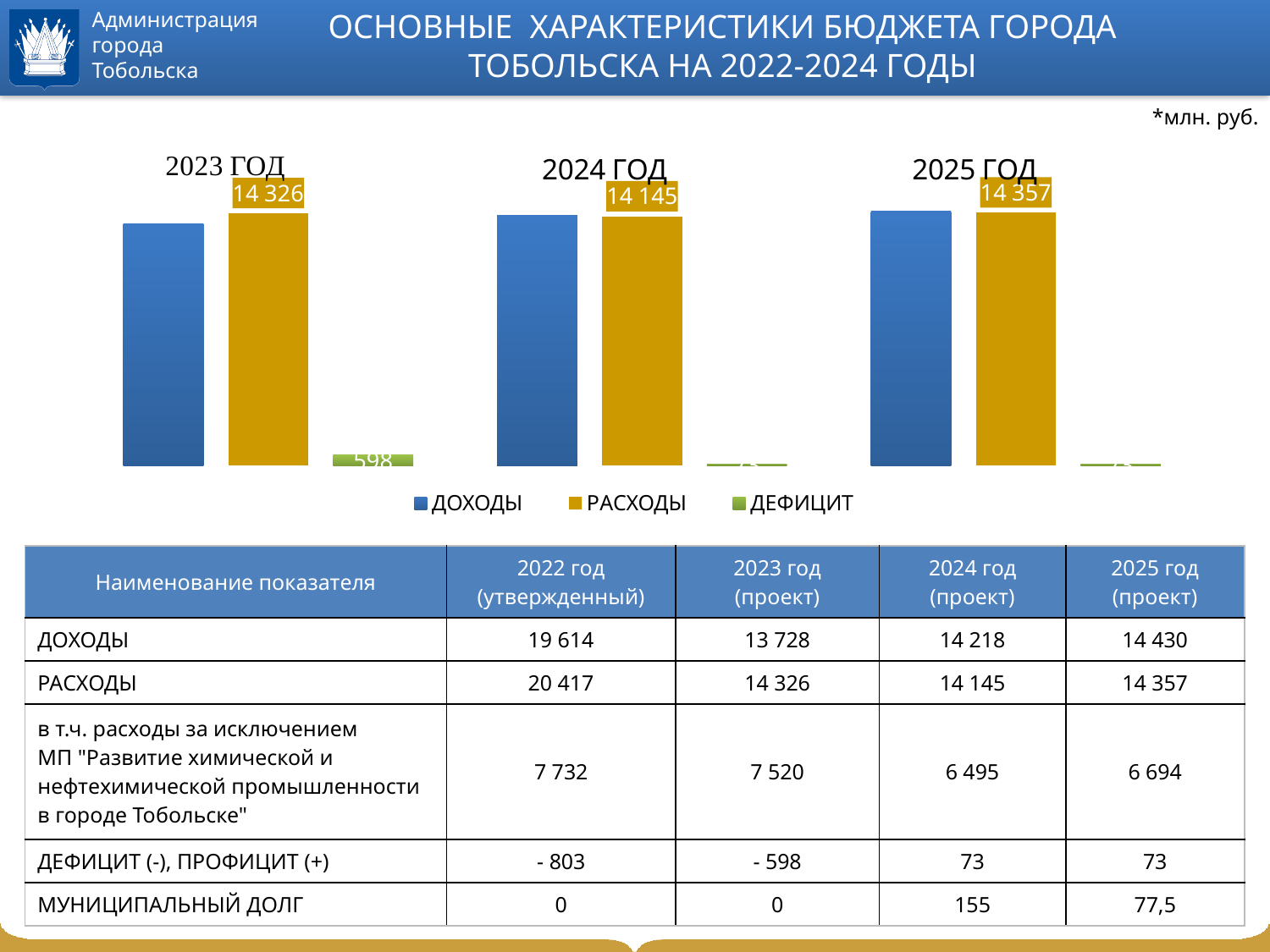
Which year has the highest РАСХОДЫ value in the chart? 2025 ГОД What type of chart is shown on the slide? Bar chart Which is larger, the РАСХОДЫ value for 2023 ГОД or for 2025 ГОД? 2025 ГОД What is the value of РАСХОДЫ for 2023 ГОД? 14 326 What is the value of РАСХОДЫ for 2025 ГОД? 14 357 How many year groups are shown in the chart? 3 What is the value of РАСХОДЫ for 2024 ГОД? 14 145 Which year has the lowest РАСХОДЫ value in the chart? 2024 ГОД What is the difference between the РАСХОДЫ values for 2025 ГОД and 2024 ГОД? 212 In the 2023 ГОД group, which bar is taller, ДОХОДЫ or РАСХОДЫ? РАСХОДЫ What is the difference between the РАСХОДЫ values for 2023 ГОД and 2024 ГОД? 181 How many series does the chart legend list? 3